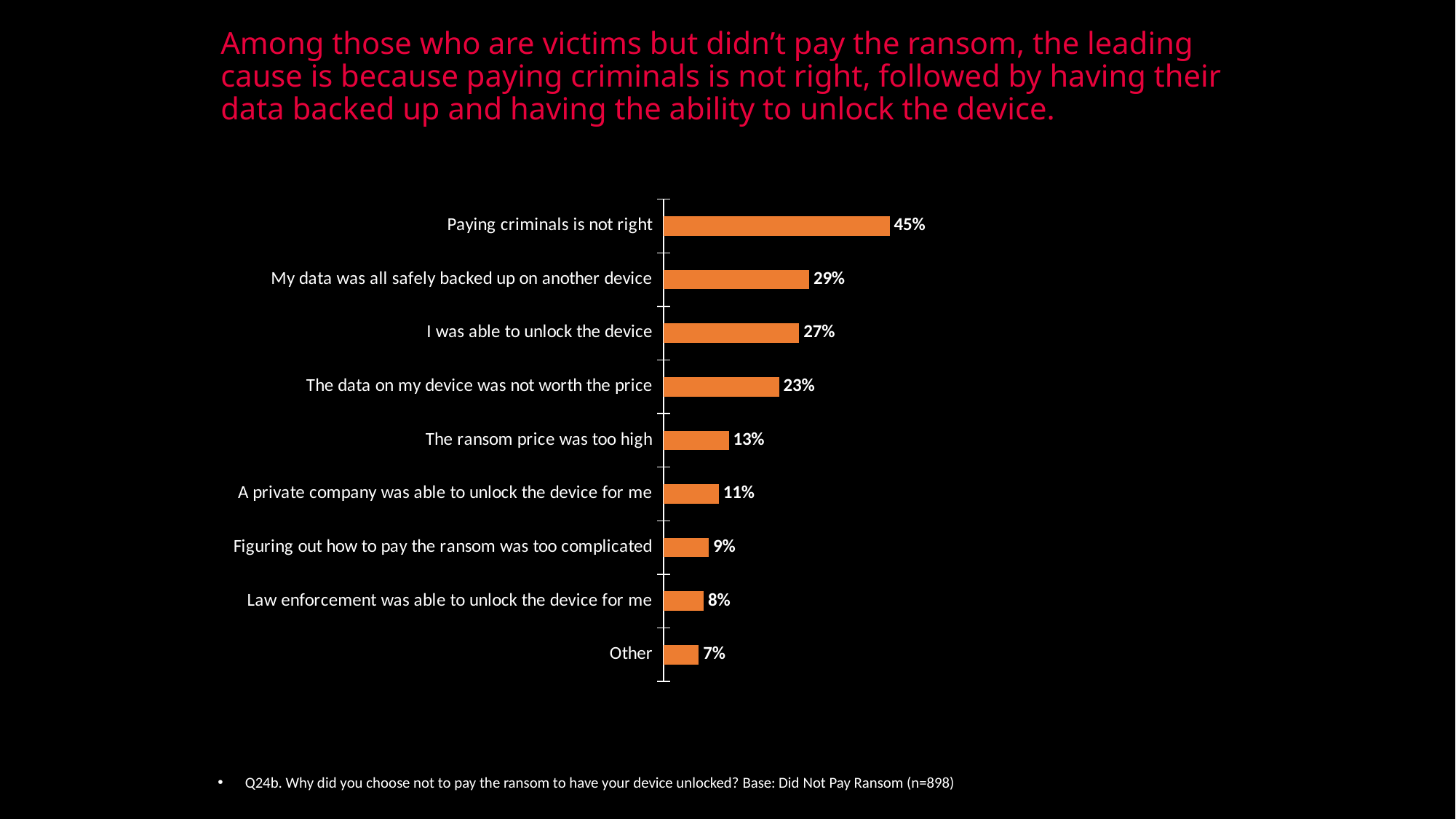
How many categories are shown in the chart? 9 What colour are the bars in the chart? Orange What is the value for 'My data was all safely backed up on another device'? 29% What is the difference between 'Paying criminals is not right' and 'My data was all safely backed up on another device'? 16% What kind of chart is shown on the slide? Bar chart What percentage chose 'The ransom price was too high'? 13% What is the value for 'Law enforcement was able to unlock the device for me'? 8% Which reason has the highest percentage? Paying criminals is not right What percentage of respondents said 'Paying criminals is not right'? 45% Which category has the lowest percentage? Other What is the difference between 'I was able to unlock the device' and 'The data on my device was not worth the price'? 4% Which is larger: 'A private company was able to unlock the device for me' or 'Figuring out how to pay the ransom was too complicated'? A private company was able to unlock the device for me